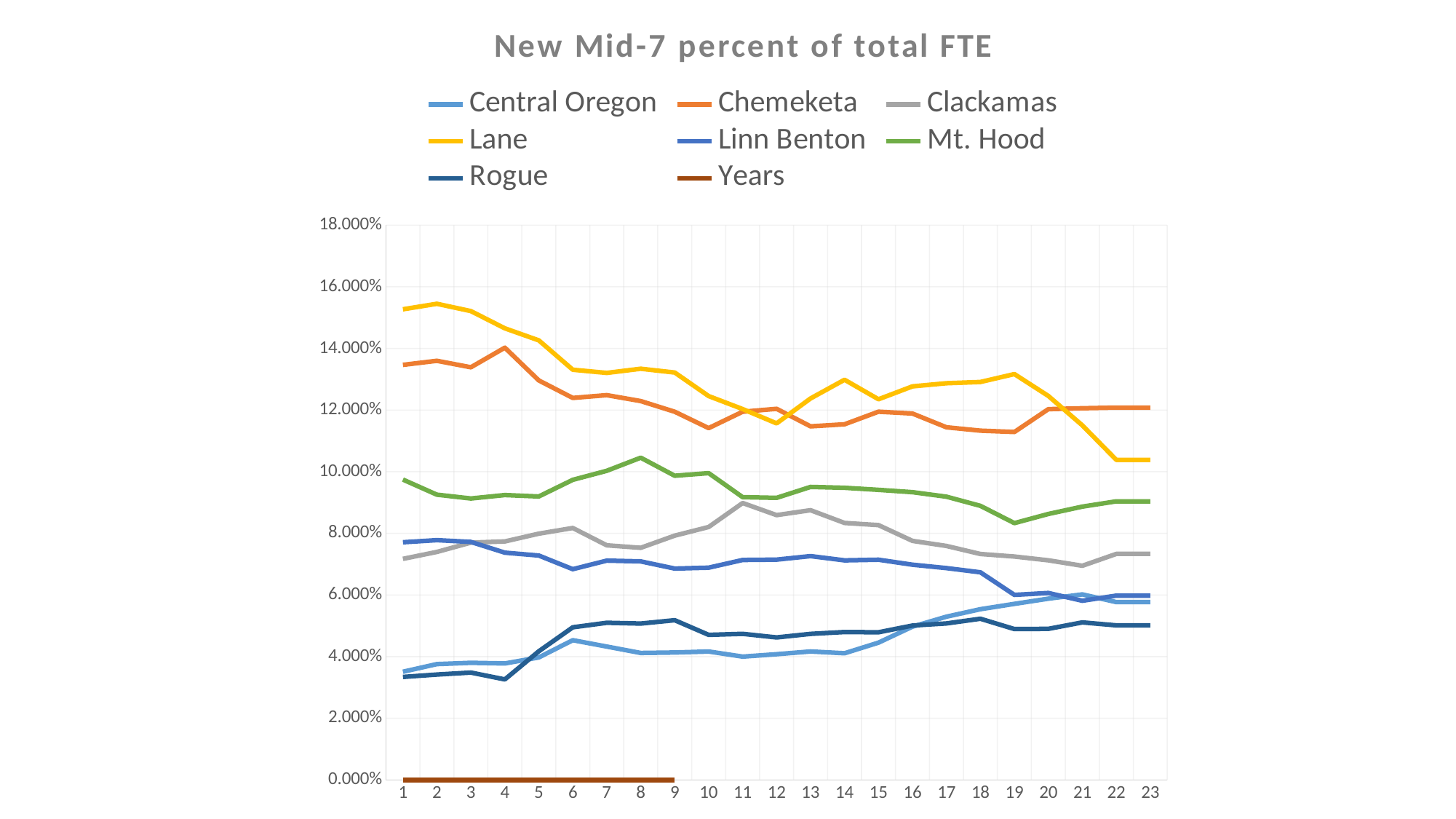
Is the value for Mt. Hood at point 8 greater or less than 10.000%? greater How many series does the legend list? 8 Is the value for Lane at point 1 greater or less than 14.000%? greater What is the title of the chart? New Mid-7 percent of total FTE Is the value for Rogue at point 23 greater or less than 6.000%? less At point 23, which is higher, Chemeketa or Lane? Chemeketa Does the Central Oregon line rise or fall from point 1 to point 23? rise What kind of chart is shown on the slide? line chart How many points are there along the x axis? 23 Which series has the lowest value at point 4? Years Does the Lane line rise or fall from point 1 to point 23? fall Which series has the highest value at point 1? Lane